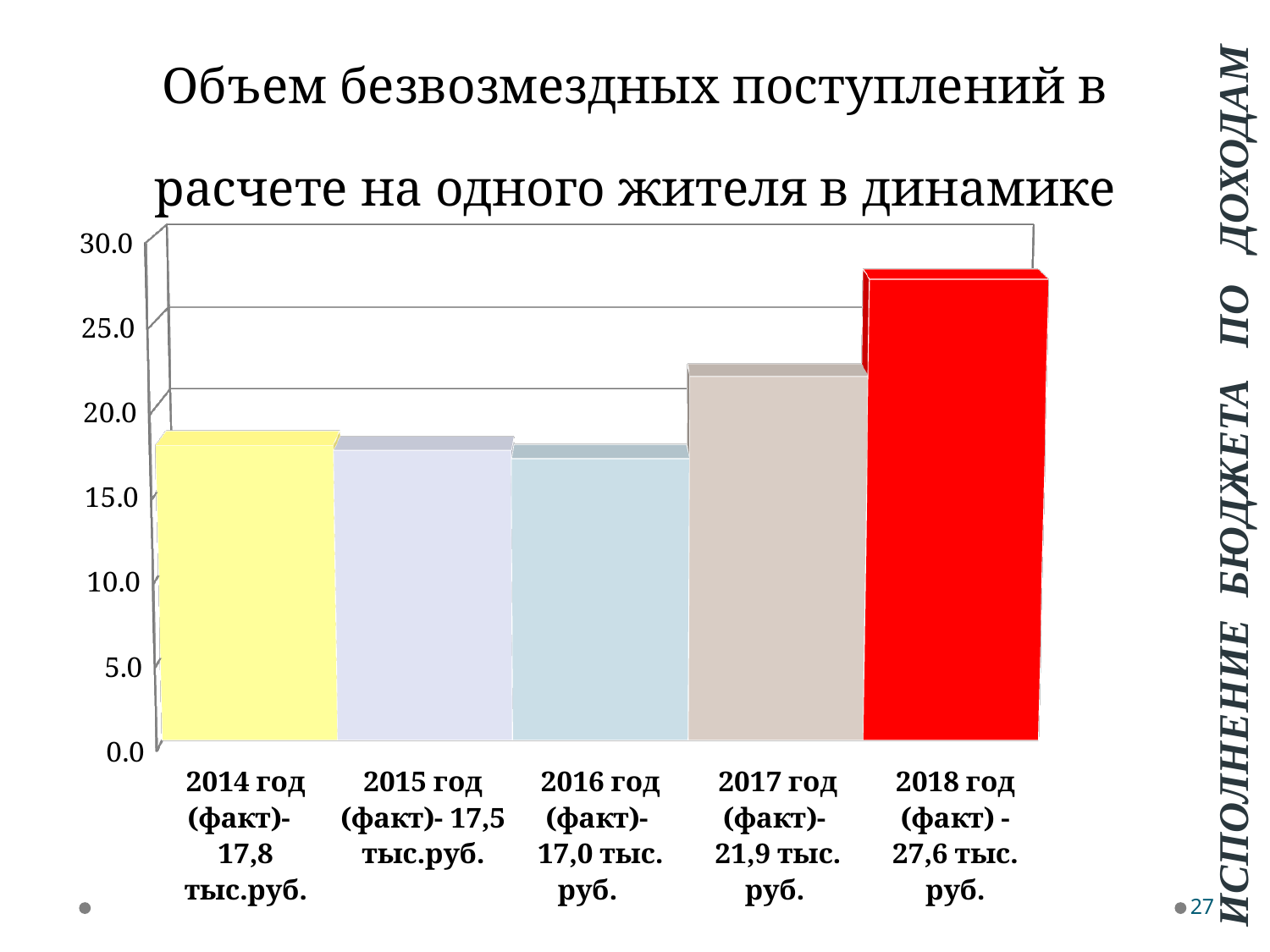
Which year has the lowest value in the chart? 2016 год What colour is the bar for 2018 год? red Which year has the highest value in the chart? 2018 год What is the difference between the 2014 and 2016 values? 0,8 тыс. руб. What is the difference between the 2018 and 2017 values? 5,7 тыс. руб. What value is shown for 2017 год (факт) in the chart? 21,9 тыс. руб. Which is larger, the value for 2015 год or the value for 2017 год? 2017 год What kind of chart is shown on the slide? bar chart Is the value for 2018 год greater or less than 25.0? greater How many years (bars) are shown in the chart? 5 What value is shown for 2018 год (факт) in the chart? 27,6 тыс. руб. What value is shown for 2014 год (факт) in the chart? 17,8 тыс.руб.